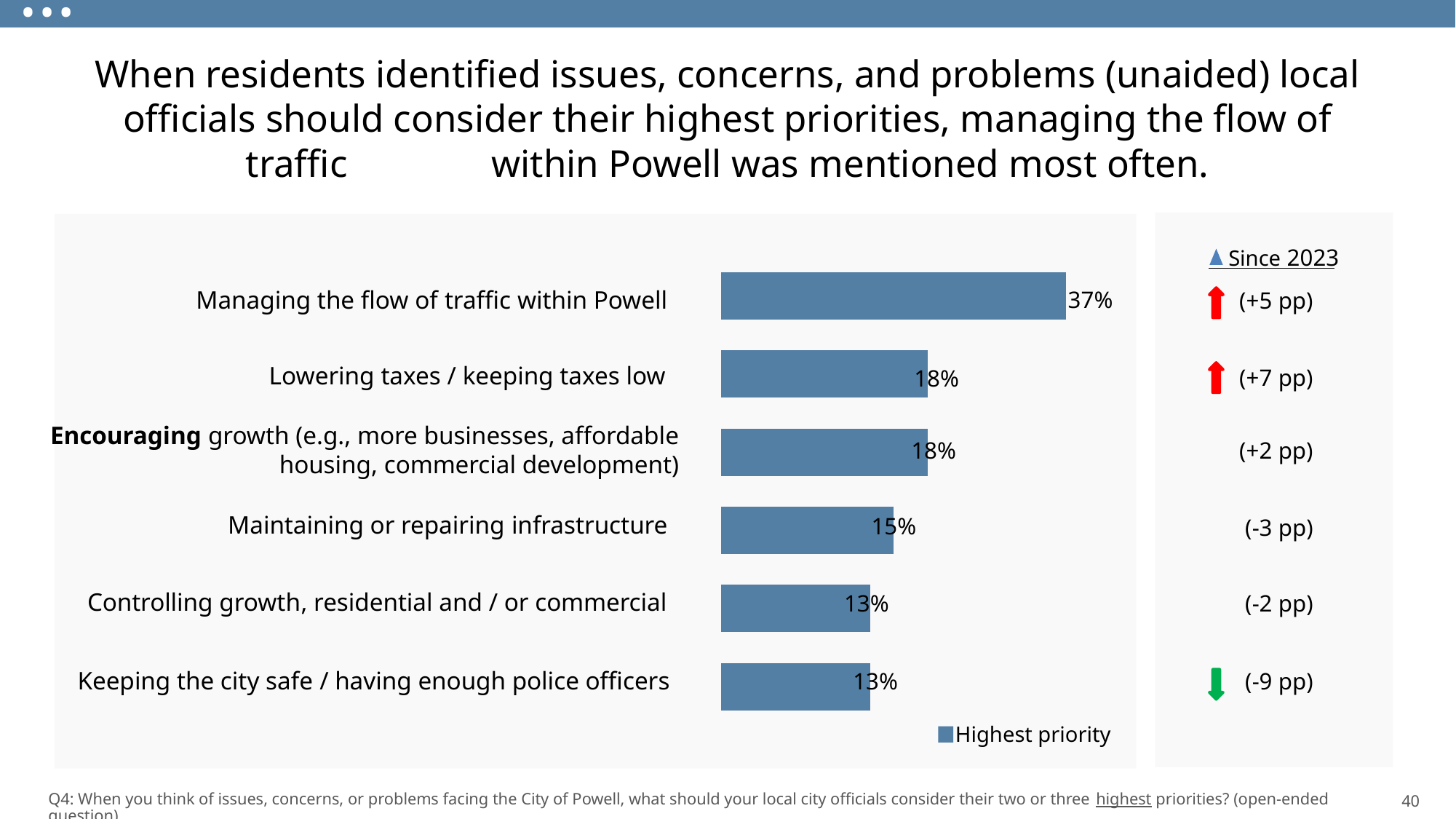
What is the difference between the value for 'Maintaining or repairing infrastructure' and the value for 'Keeping the city safe / having enough police officers'? 2 percentage points What percentage of residents mentioned managing the flow of traffic within Powell as a highest priority? 37% What is the value for 'Maintaining or repairing infrastructure'? 15% What is the legend entry for the series shown in the chart? Highest priority How many series does the legend list? 1 How many categories are shown in the bar chart? 6 What is the value for 'Keeping the city safe / having enough police officers'? 13% What kind of chart is shown on the slide? Bar chart What is the difference between the value for managing the flow of traffic within Powell and the value for lowering taxes / keeping taxes low? 19 percentage points According to the 'Since 2023' column, what is the change for 'Keeping the city safe / having enough police officers'? -9 pp Which category has the highest value in the chart? Managing the flow of traffic within Powell Which is larger: the value for 'Maintaining or repairing infrastructure' or the value for 'Controlling growth, residential and / or commercial'? Maintaining or repairing infrastructure